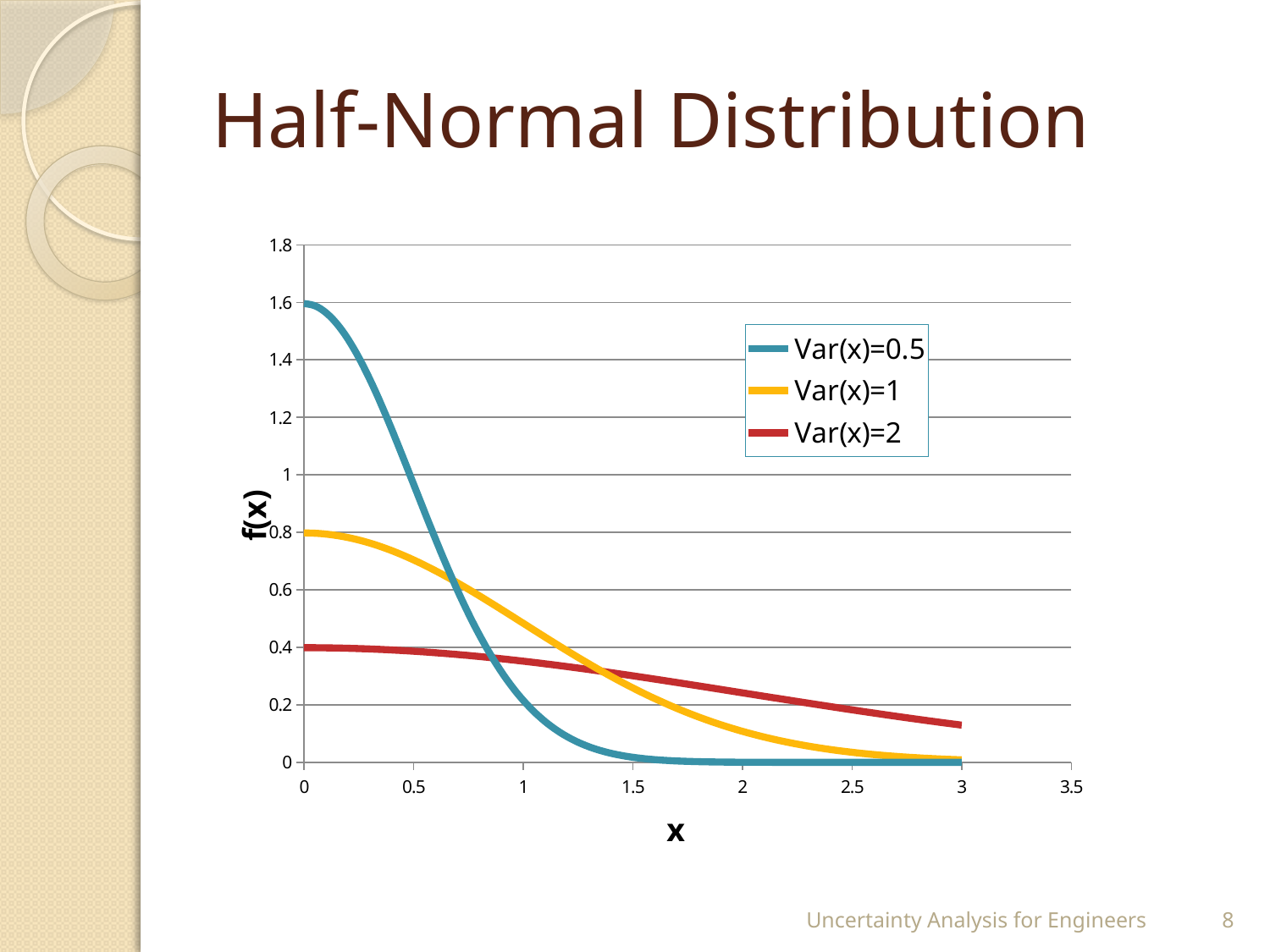
Do the values of the Var(x)=0.5 series rise or fall as x increases? fall What is the value of f(x) at x = 0 for the Var(x)=1 series? 0.8 Which series has the highest value at x = 2? Var(x)=2 What is the value of f(x) at x = 0 for the Var(x)=2 series? 0.4 How many series does the legend list? 3 What is the label of the vertical axis? f(x) At x = 0.5, which series has the larger value, Var(x)=0.5 or Var(x)=1? Var(x)=0.5 Which series has the highest value at x = 0? Var(x)=0.5 What is the value of f(x) at x = 0 for the Var(x)=0.5 series? 1.6 What kind of chart is shown on the slide? line chart Is the value of the Var(x)=0.5 series at x = 1 greater or less than 0.4? less What is the title of the chart? Half-Normal Distribution